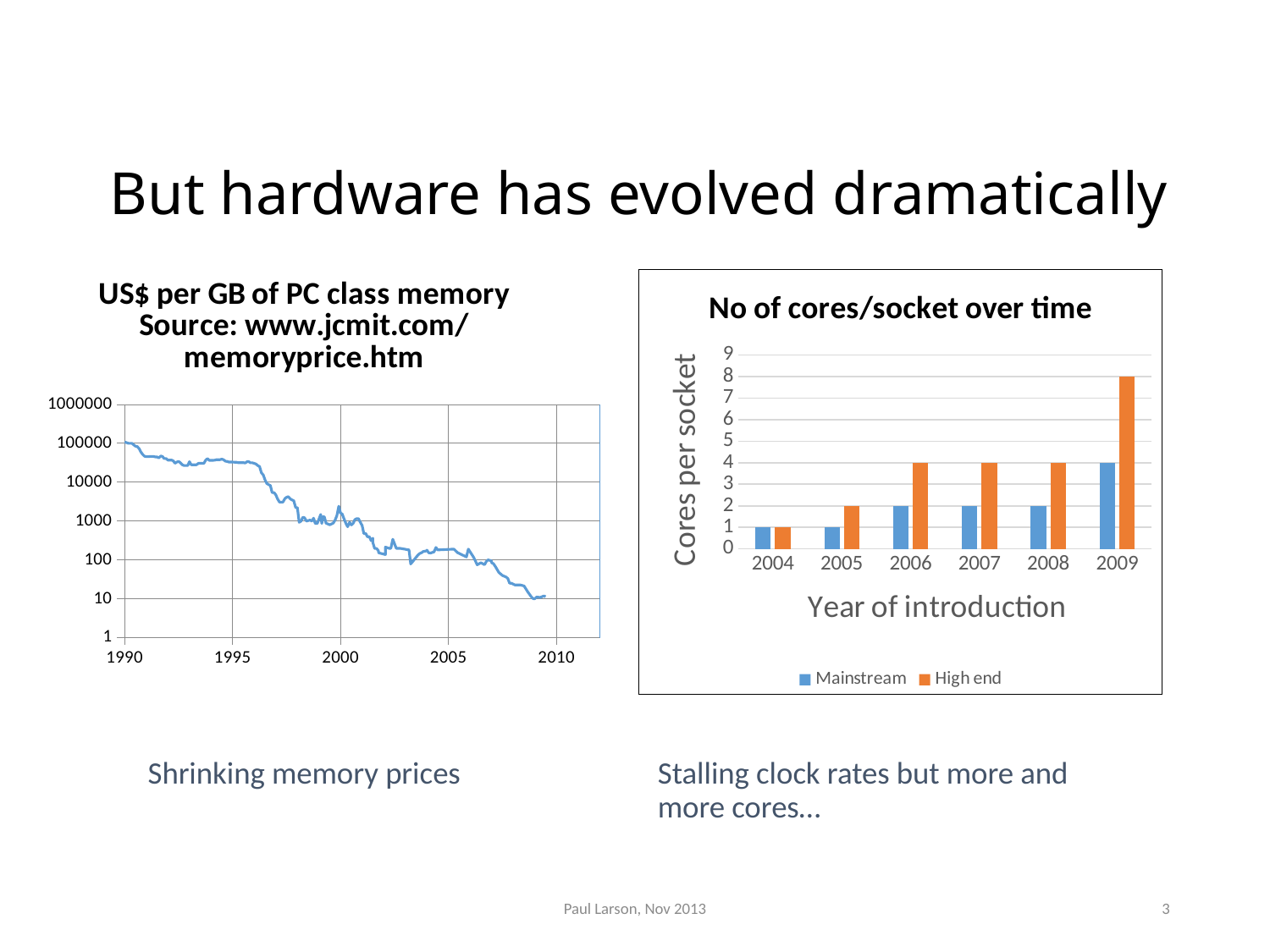
In the 'US$ per GB of PC class memory' chart, do the values rise or fall from 1990 to 2010? fall In the 'No of cores/socket over time' chart, what is the High end value for 2009? 8 In the 'No of cores/socket over time' chart, which is larger for 2007, Mainstream or High end? High end In the 'No of cores/socket over time' chart, what is the difference between the High end and Mainstream values for 2009? 4 In the 'US$ per GB of PC class memory' chart, is the value in 1995 greater or less than 10000? greater What kind of chart is the 'No of cores/socket over time' chart? bar chart In the 'No of cores/socket over time' chart, how many years are shown on the x axis? 6 In the 'No of cores/socket over time' chart, what is the High end value for 2005? 2 What kind of chart is the 'US$ per GB of PC class memory' chart on the left? line chart In the 'No of cores/socket over time' chart, which year has the highest Mainstream value? 2009 In the 'No of cores/socket over time' chart, what is the Mainstream value for 2006? 2 In the 'No of cores/socket over time' chart, how many series does the legend list? 2